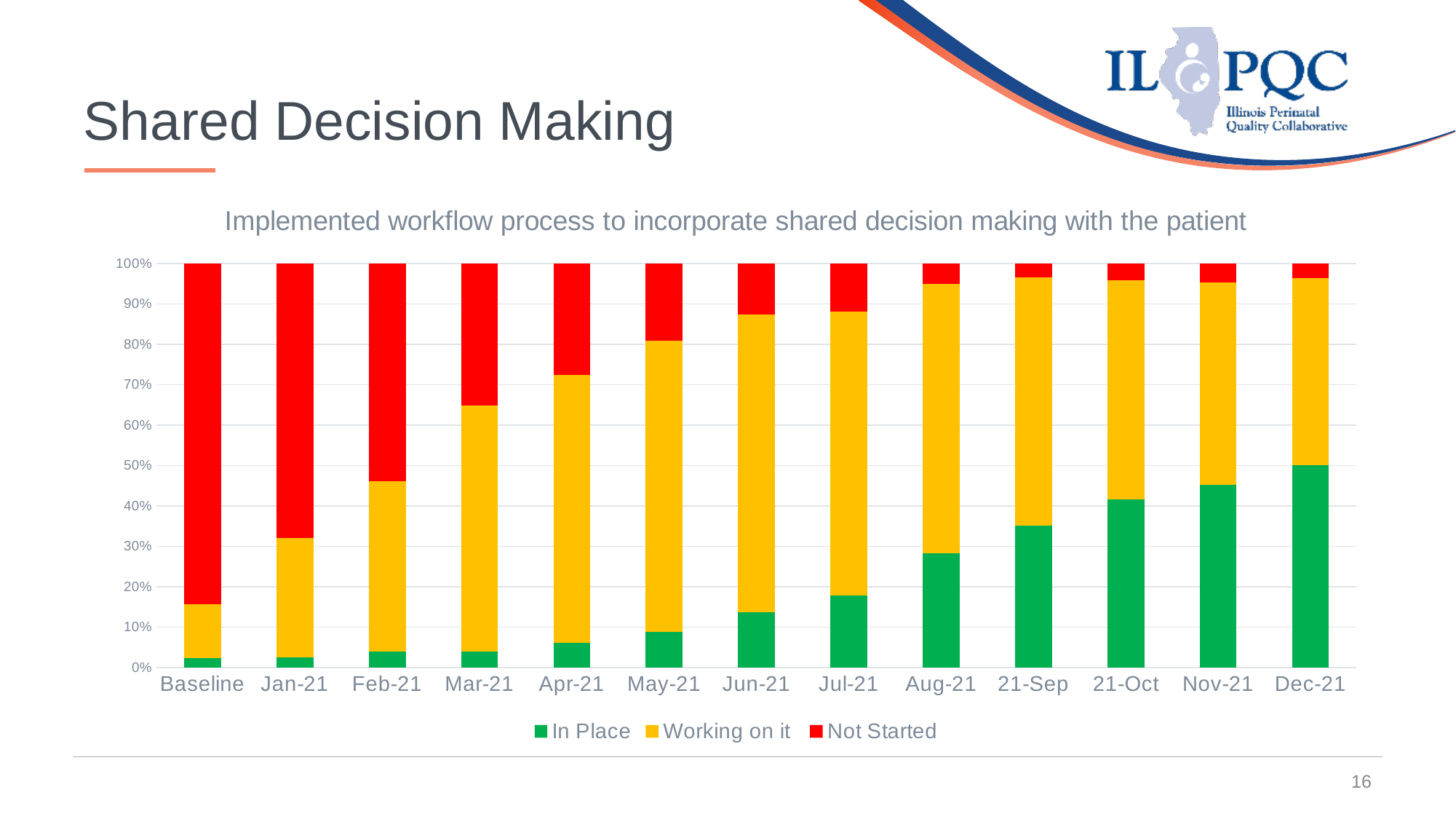
How many series does the chart legend list? 3 Is the 'Not Started' value for Baseline greater or less than 80%? greater How many categories are shown along the x axis of the chart? 13 In which category is the 'Not Started' share the highest? Baseline In which category is the 'In Place' share the highest? Dec-21 Does the 'Not Started' share rise or fall from Baseline to Dec-21? Fall Which is larger: the 'In Place' share for Nov-21 or for Aug-21? Nov-21 Does the 'In Place' share rise or fall from Baseline to Dec-21? Rise Which colour represents the 'Not Started' series in the chart? Red What is the title of the chart? Implemented workflow process to incorporate shared decision making with the patient Is the 'In Place' value for Jan-21 greater or less than 10%? less What kind of chart is shown on the slide? Stacked bar chart